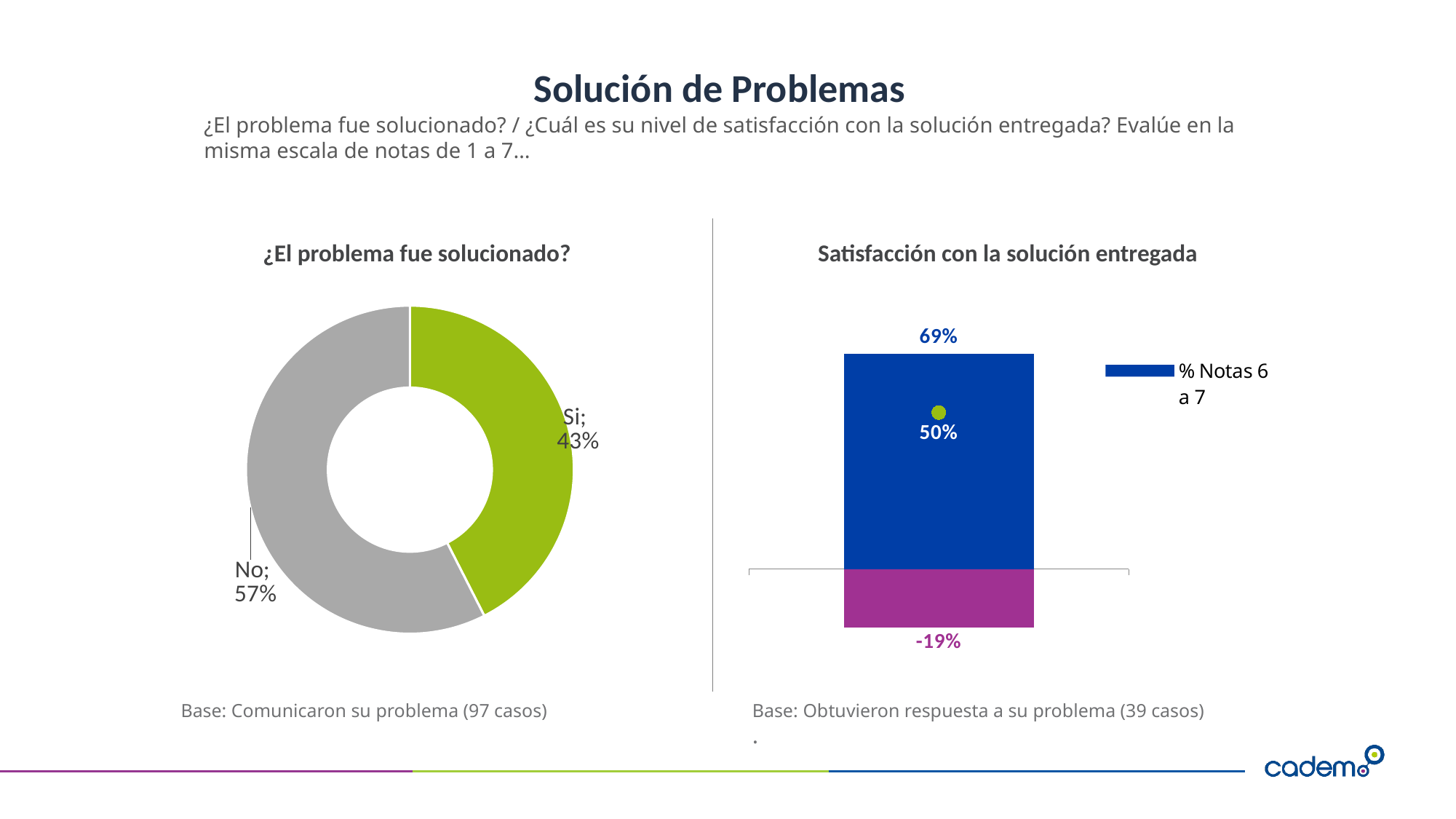
How many categories are shown in the chart titled "¿El problema fue solucionado?"? 2 What kind of chart is the one titled "Satisfacción con la solución entregada"? Bar chart In the chart titled "Satisfacción con la solución entregada", what is the legend entry shown? % Notas 6 a 7 In the chart titled "Satisfacción con la solución entregada", what value is shown for the blue bar (% Notas 6 a 7)? 69% In the chart titled "¿El problema fue solucionado?", what percentage answered "Si"? 43% In the chart titled "¿El problema fue solucionado?", what percentage answered "No"? 57% What kind of chart is the one titled "¿El problema fue solucionado?"? Donut (pie) chart In the chart titled "¿El problema fue solucionado?", what colour is the "Si" slice? Green In the chart titled "¿El problema fue solucionado?", which response has the larger share? No In the chart titled "Satisfacción con la solución entregada", what value is shown for the purple bar below the axis? -19% In the chart titled "Satisfacción con la solución entregada", what value is shown next to the green dot? 50%